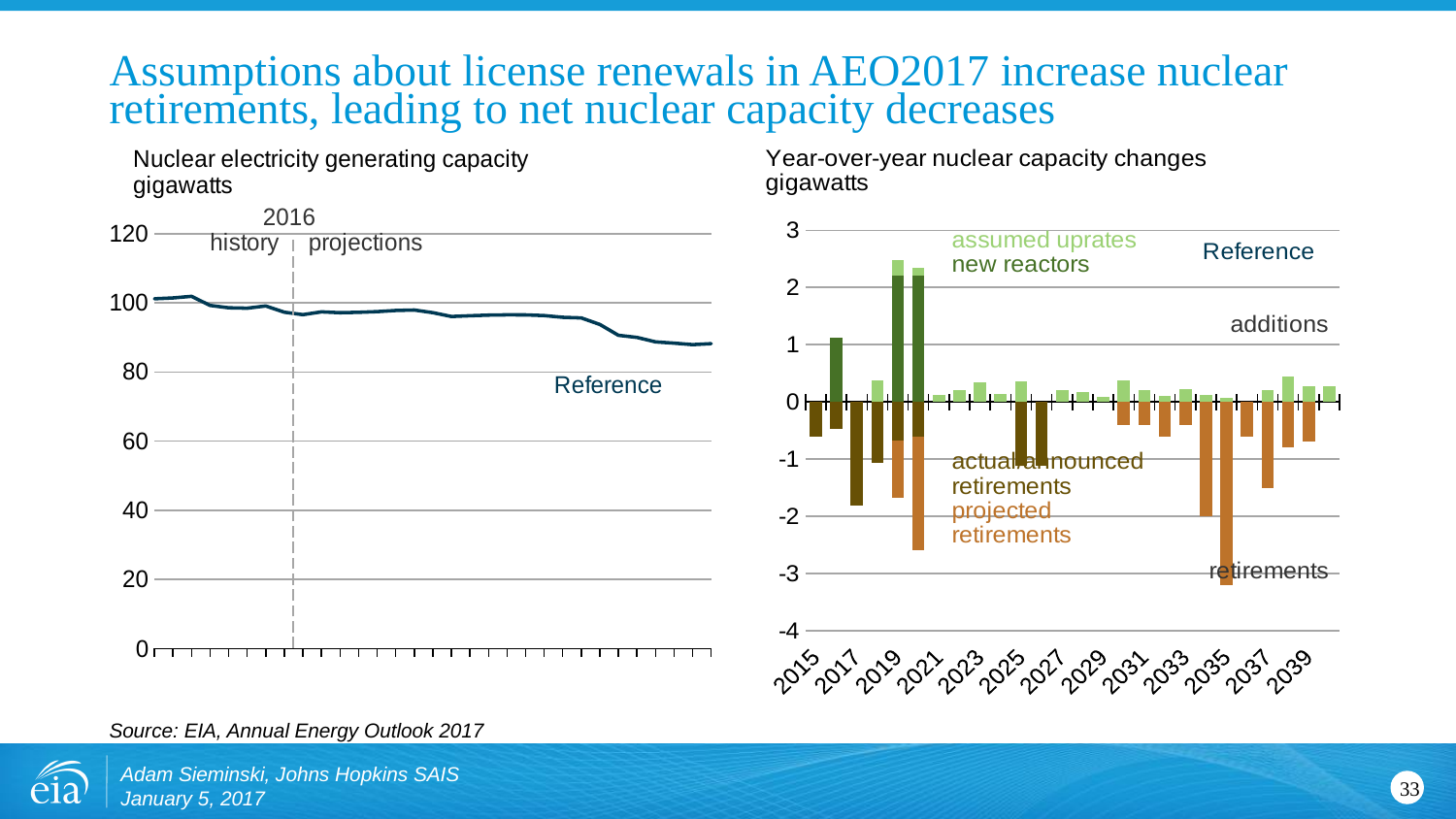
What kind of chart is the left chart, 'Nuclear electricity generating capacity'? line chart What kind of chart is the right chart, 'Year-over-year nuclear capacity changes'? bar chart In the left chart, 'Nuclear electricity generating capacity', is the value of the Reference line at the start of the history period greater or less than 80? greater In the left chart, 'Nuclear electricity generating capacity', what is the highest value shown on the vertical axis? 120 In the right chart, 'Year-over-year nuclear capacity changes', what is the last year labeled on the horizontal axis? 2039 In the left chart, 'Nuclear electricity generating capacity', does the Reference line generally rise or fall from left to right? fall In the right chart, 'Year-over-year nuclear capacity changes', is the largest negative (retirement) bar greater or less than -2? less In the right chart, 'Year-over-year nuclear capacity changes', is the tallest positive (additions) bar greater or less than 2? greater In the right chart, 'Year-over-year nuclear capacity changes', how many series does the legend list? 4 In the right chart, 'Year-over-year nuclear capacity changes', what is the first year labeled on the horizontal axis? 2015 In the left chart, 'Nuclear electricity generating capacity', what year marks the boundary between history and projections? 2016